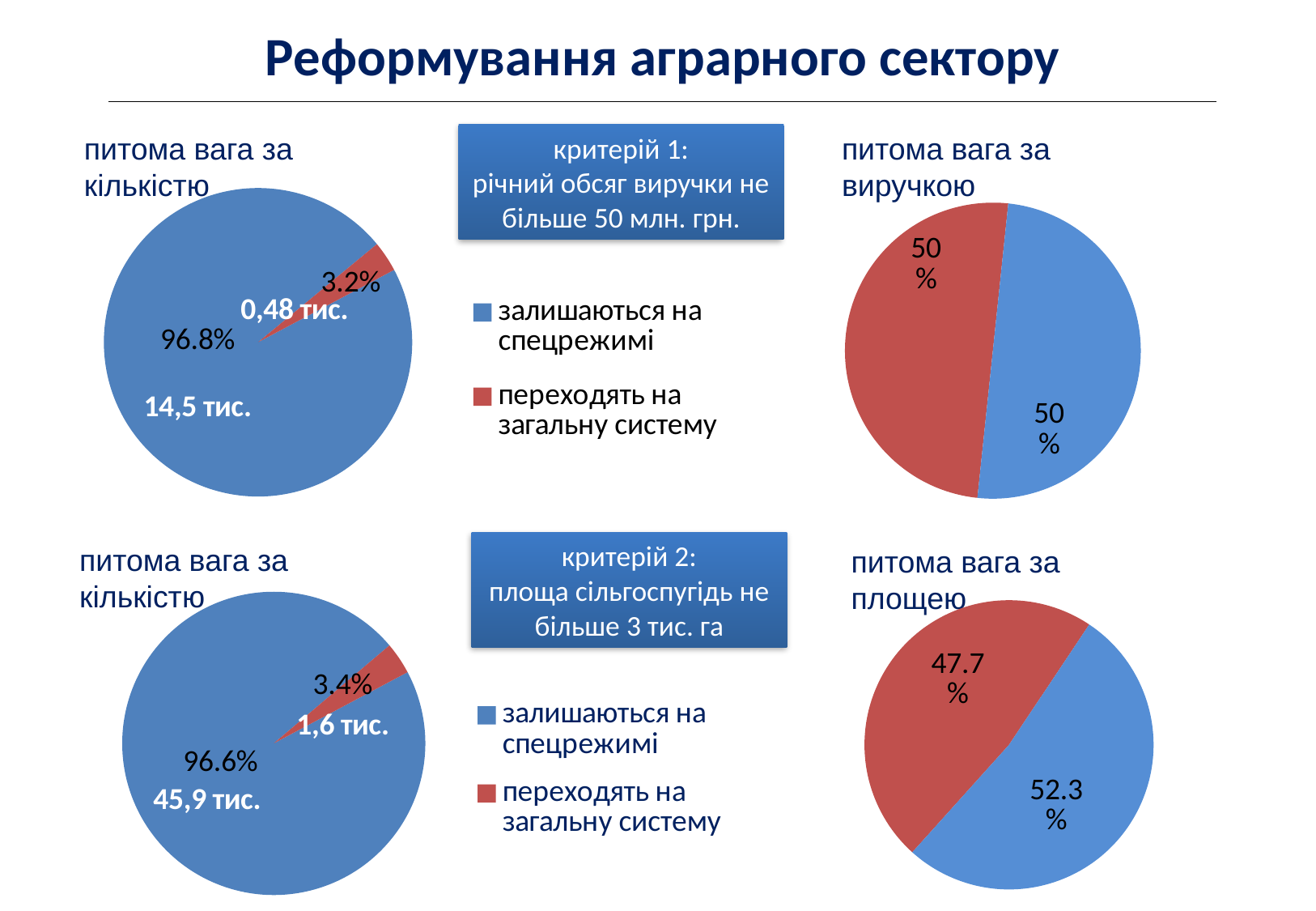
How many pie charts are on the slide? 4 In the top-left pie chart (питома вага за кількістю, критерій 1), what share is labelled for the red slice (переходять на загальну систему)? 3.2% In the top-right pie chart (питома вага за виручкою), what share is shown for the red slice? 50% In the bottom-right pie chart (питома вага за площею), what is the difference between the blue slice's share and the red slice's share? 4.6% In the bottom-right pie chart (питома вага за площею), what share is shown for the blue slice (залишаються на спецрежимі)? 52.3% In the bottom-right pie chart (питома вага за площею), which slice is larger, the blue one or the red one? the blue one How many series does the legend next to the top charts list? 2 In the bottom-left pie chart (питома вага за кількістю, критерій 2), what count in thousands is printed on the red slice? 1,6 тис. In the top-left pie chart (питома вага за кількістю, критерій 1), what count in thousands is printed on the blue slice? 14,5 тис. In the top-left pie chart (питома вага за кількістю, критерій 1), what share is labelled for the blue slice (залишаються на спецрежимі)? 96.8% What kind of chart is used for all four charts on the slide? pie chart In the bottom-left pie chart (питома вага за кількістю, критерій 2), what share is labelled for the red slice (переходять на загальну систему)? 3.4%